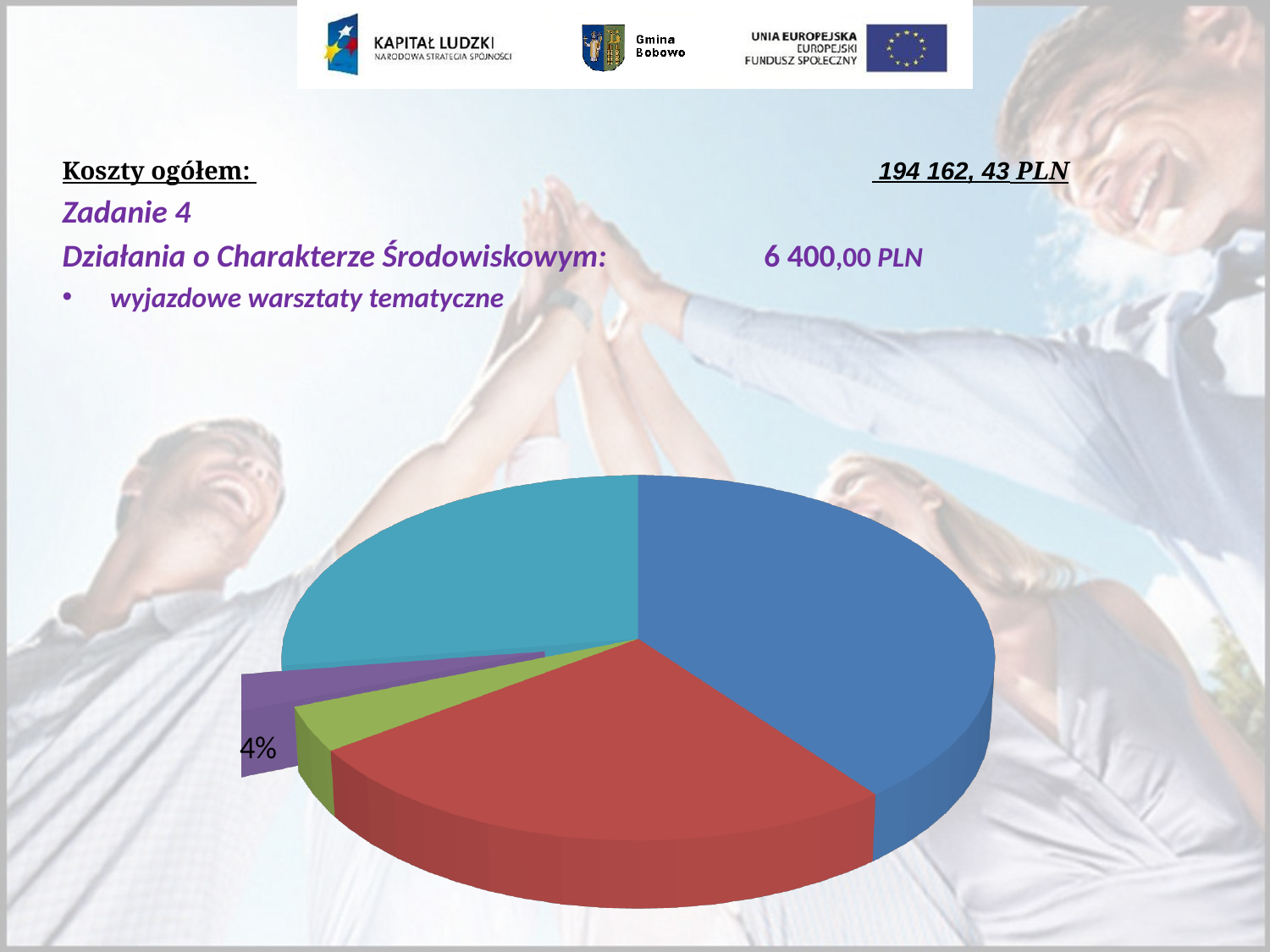
Which colour slice is pulled out (exploded) from the pie chart? purple What share of the pie does the purple slice represent? 4% What percentage is printed on the pie chart's labelled slice? 4% Which is larger in the pie chart, the blue slice or the teal slice? blue Does the pie chart display a legend? No Which colour slice is the largest in the pie chart? blue How many slices does the pie chart have? 5 Which is larger in the pie chart, the blue slice or the red slice? blue Which is larger in the pie chart, the red slice or the purple slice? red What kind of chart is shown on the slide? pie chart